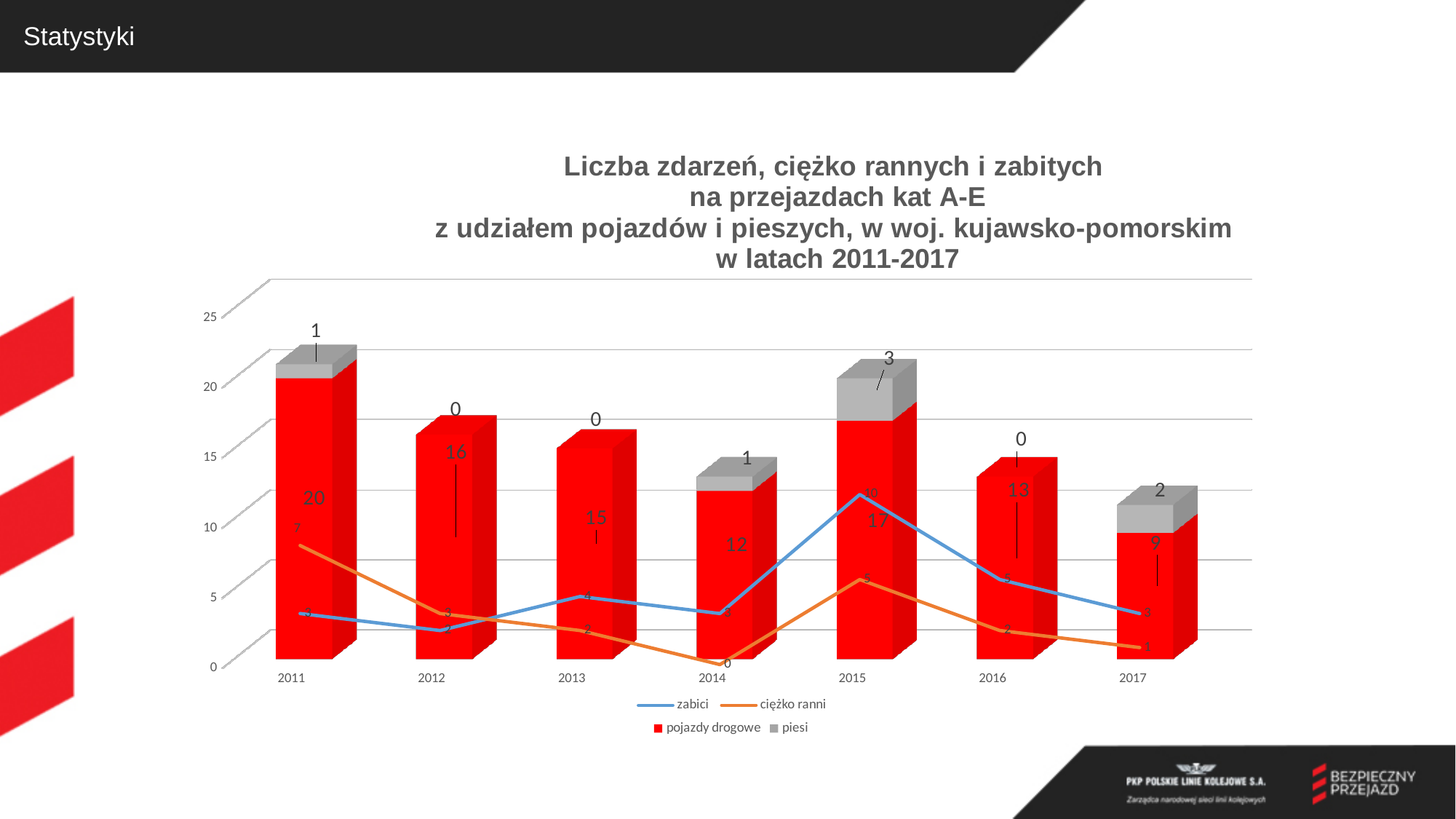
Which is larger, the pojazdy drogowe value for 2015 or for 2016? 2015 What is the total of the stacked bar for 2015 (pojazdy drogowe plus piesi)? 20 What is the value for piesi in 2015? 3 Which series is drawn as an orange line? ciężko ranni How many years are shown on the x axis? 7 What is the value for ciężko ranni in 2011? 7 What is the value for pojazdy drogowe in 2011? 20 How many series does the legend list? 4 Which year has the highest value for pojazdy drogowe? 2011 What is the difference between the pojazdy drogowe values for 2011 and 2017? 11 Which year has the lowest value for pojazdy drogowe? 2017 What is the value for zabici in 2015? 10